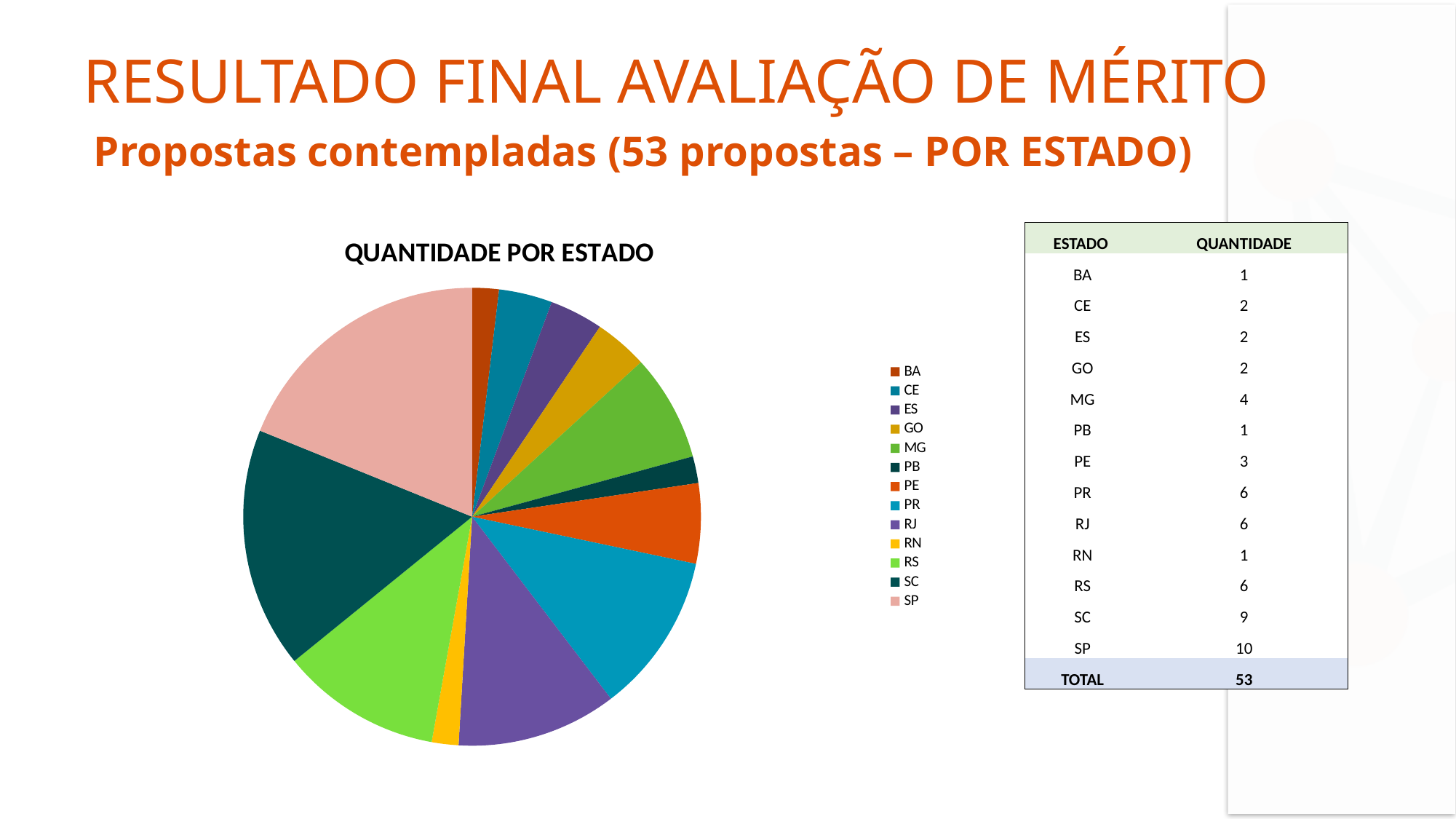
What is the difference between the quantities for SC and MG? 5 What is the quantity for SC? 9 How many states (categories) are shown in the pie chart? 13 What kind of chart is shown on the slide? pie chart What is the quantity for PE? 3 What is the total quantity across all states? 53 Which has a larger quantity, SC or PR? SC Which state has the largest slice in the pie chart? SP What is the title of the pie chart? QUANTIDADE POR ESTADO What is the difference between the quantities for SP and SC? 1 What is the quantity for MG? 4 What is the quantity for SP? 10